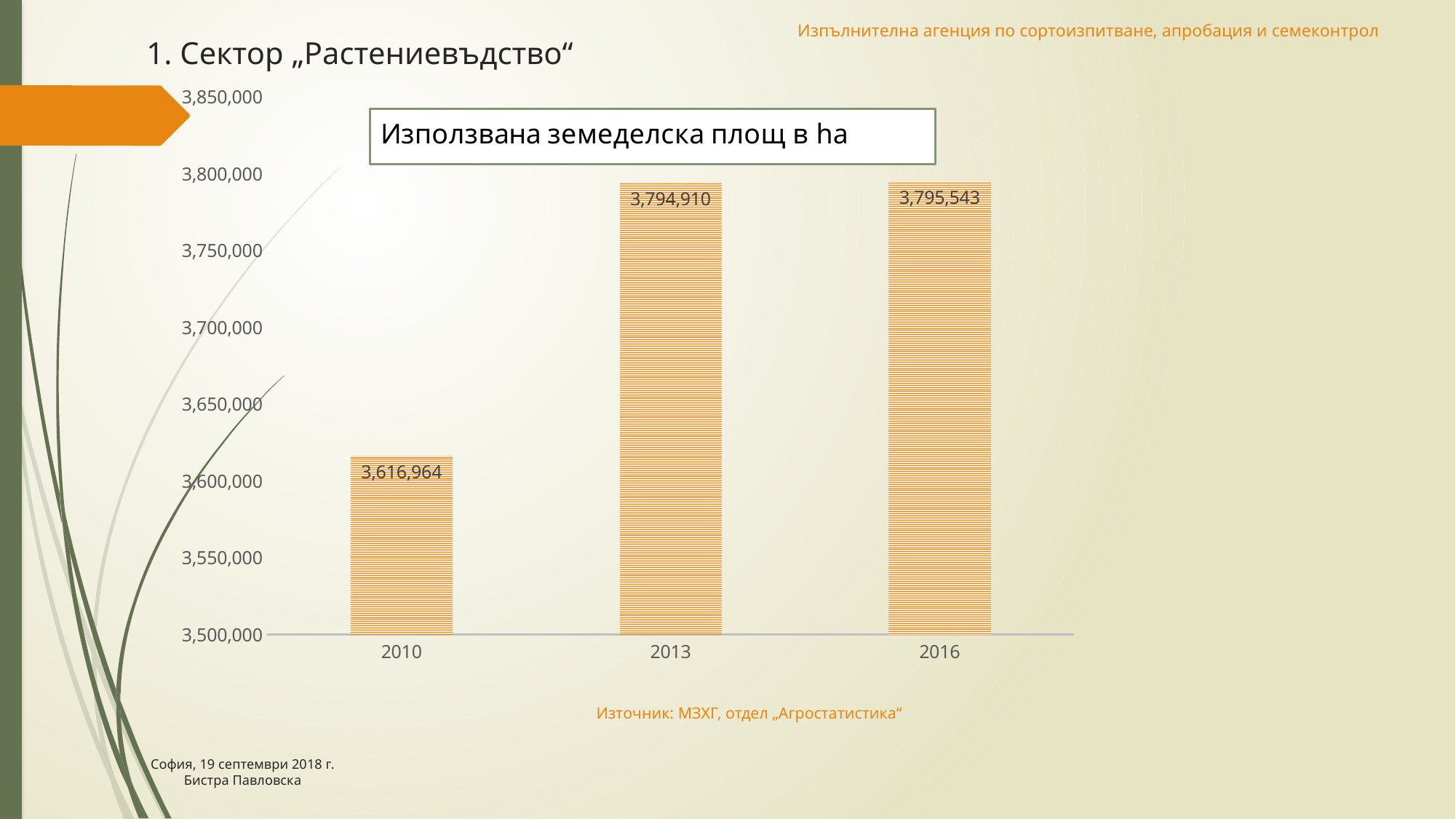
What is the value for 2016 in the chart? 3,795,543 What kind of chart is shown on the slide? bar chart What is the difference between the values for 2016 and 2013? 633 Which year has the highest value in the chart? 2016 Which is larger, the value for 2010 or the value for 2013? 2013 What is the value for 2010 in the chart? 3,616,964 What is the difference between the values for 2013 and 2010? 177,946 Is the value for 2013 greater or less than 3,800,000? less How many years are shown in the chart? 3 Which year has the lowest value in the chart? 2010 What is the value for 2013 in the chart? 3,794,910 What is the title of the chart? Използвана земеделска площ в ha